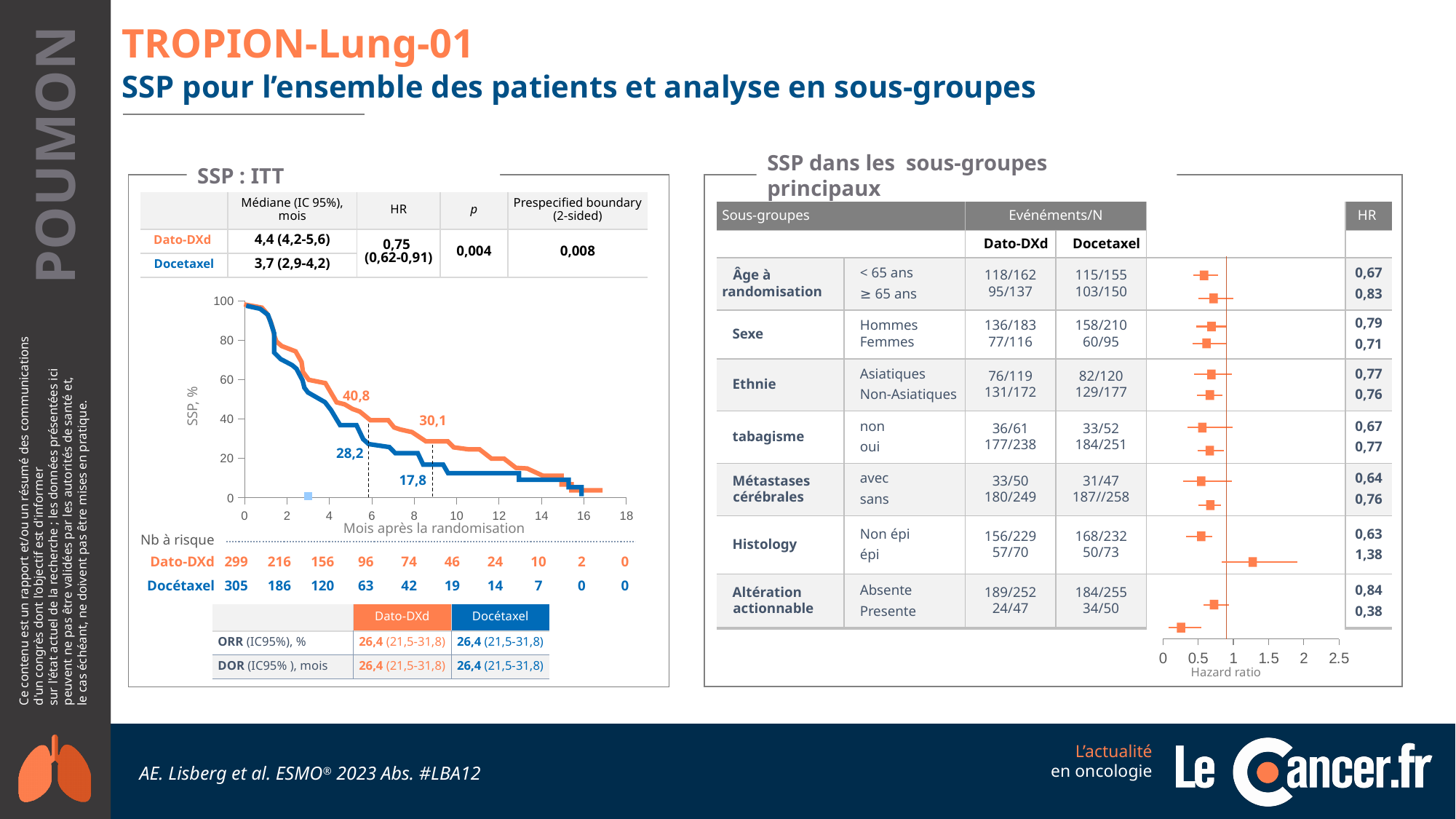
In the SSP : ITT chart, how many patients were at risk in the Dato-DXd arm at 6 months? 96 In the SSP : ITT chart, what is the labelled SSP value for Dato-DXd at the first dashed line (around 6 months)? 40,8 In the forest plot 'SSP dans les sous-groupes principaux', which subgroup has the lowest hazard ratio? Altération actionnable – Presente (0,38) In the forest plot 'SSP dans les sous-groupes principaux', what is the hazard ratio for patients with métastases cérébrales (avec)? 0,64 In the SSP : ITT chart, which arm has the higher labelled SSP at the second dashed line, Dato-DXd or Docétaxel? Dato-DXd In the forest plot 'SSP dans les sous-groupes principaux', which subgroup has the highest hazard ratio? Histology – épi (1,38) In the SSP : ITT chart, what type of chart is used to show SSP over months after randomisation? Kaplan-Meier survival curve (line chart) In the SSP : ITT chart, what is the difference between the labelled SSP values of Dato-DXd (40,8) and Docétaxel (28,2) at the first dashed line? 12,6 In the SSP : ITT chart, do the SSP curves rise or fall as months after randomisation increase? fall In the forest plot 'SSP dans les sous-groupes principaux', is the hazard ratio for Histology épi greater or less than 1? greater In the SSP : ITT chart, what is the labelled SSP value for Docétaxel at the second dashed line (around 9 months)? 17,8 In the SSP : ITT chart, what colour is the Docétaxel curve? blue